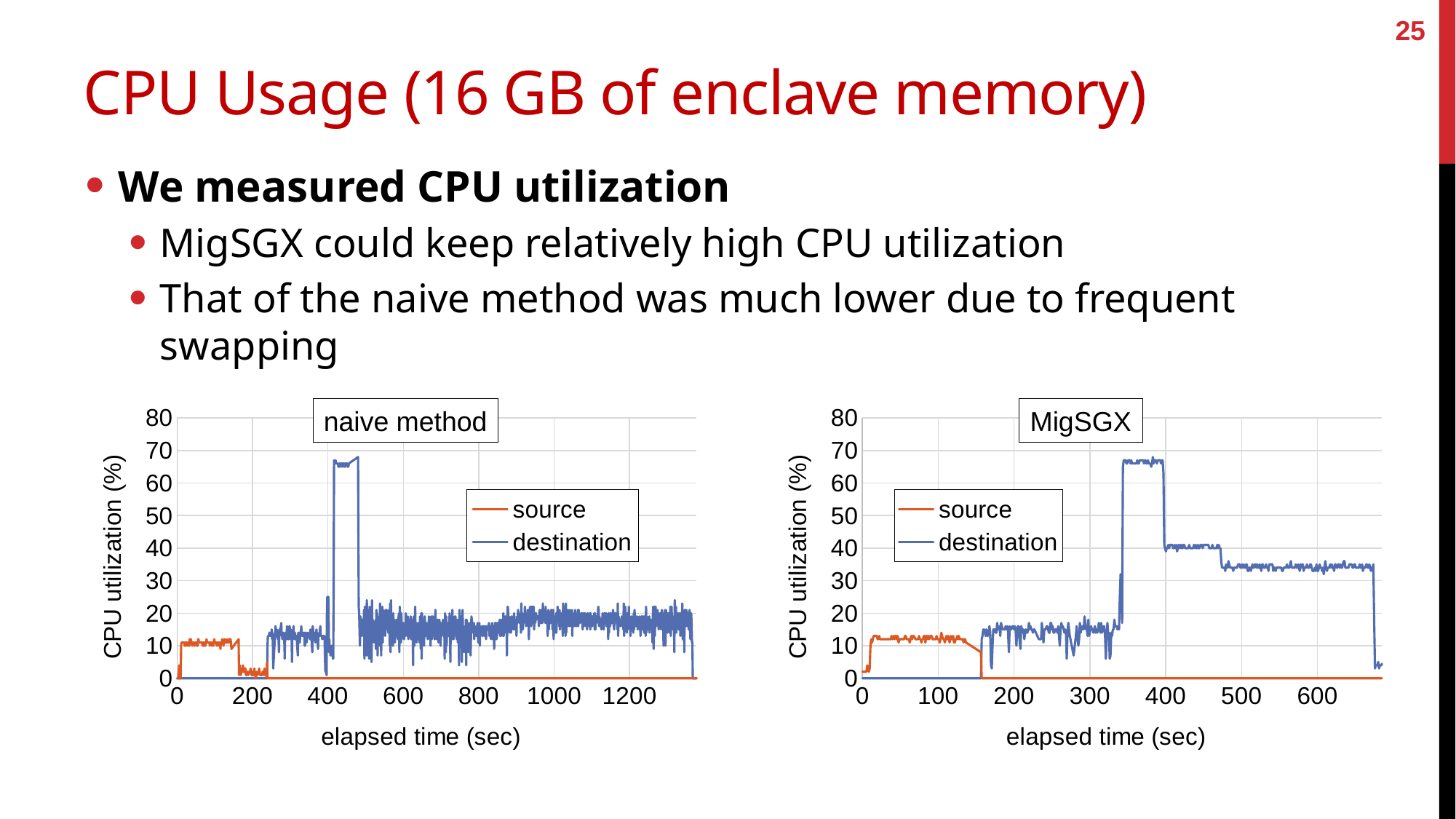
In the "naive method" chart, which series is drawn in orange? source In the "naive method" chart, is the destination series value at around 1000 sec greater or less than 30? less What is the y-axis label of the "MigSGX" chart? CPU utilization (%) How many series does the legend of the "MigSGX" chart list? 2 In the "MigSGX" chart, is the peak value of the destination series (around 350-400 sec) greater or less than 60? greater In the "naive method" chart, is the peak value of the destination series (around 400-480 sec) greater or less than 60? greater Which is larger: the destination value at around 600 sec in the "MigSGX" chart or the destination value at around 1000 sec in the "naive method" chart? MigSGX destination at 600 sec What kind of chart is the "naive method" chart? line chart In the "MigSGX" chart, does the destination series rise or fall between about 400 sec and 650 sec? fall In the "naive method" chart, does the source series rise or fall between about 150 sec and 250 sec? fall